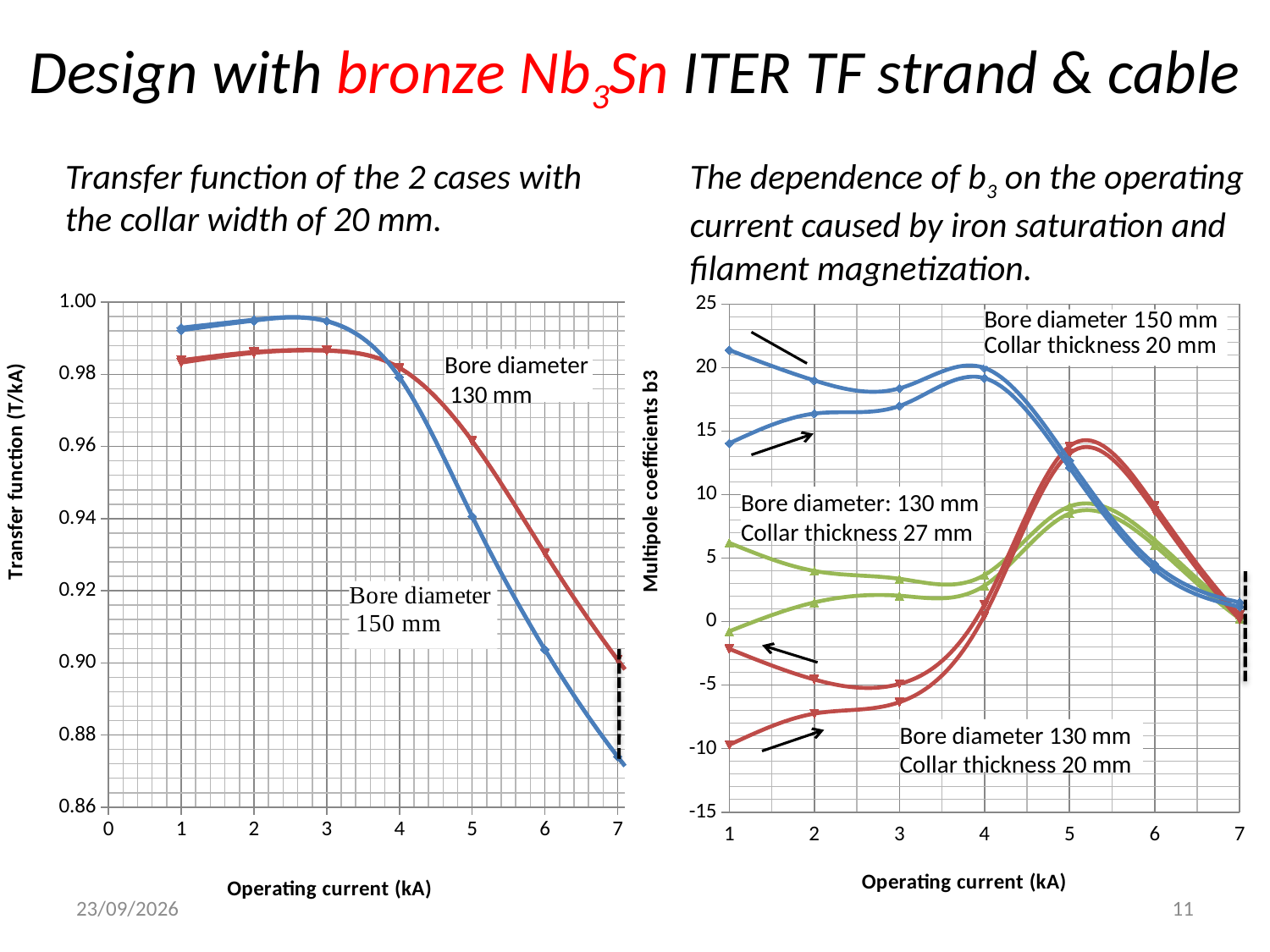
In the left chart, is the transfer function for the 150 mm bore diameter at 6 kA greater or less than 0.92? less In the left chart, which bore diameter has the higher transfer function at 7 kA, 130 mm or 150 mm? 130 mm In the right chart, is the lower red curve (bore diameter 130 mm, collar thickness 20 mm) at 1 kA greater or less than -5? less In the left chart, is the transfer function for the 130 mm bore diameter at 7 kA greater or less than 0.88? greater In the left chart, does the transfer function rise or fall as the operating current increases from 3 kA to 7 kA? fall In the left chart, which bore diameter has the higher transfer function at 1 kA, 130 mm or 150 mm? 150 mm In the right chart, what is the label of the y axis? Multipole coefficients b3 What kind of chart is the left chart, 'Transfer function' versus operating current? line chart In the right chart, what collar thickness is given for the green curves with bore diameter 130 mm? 27 mm